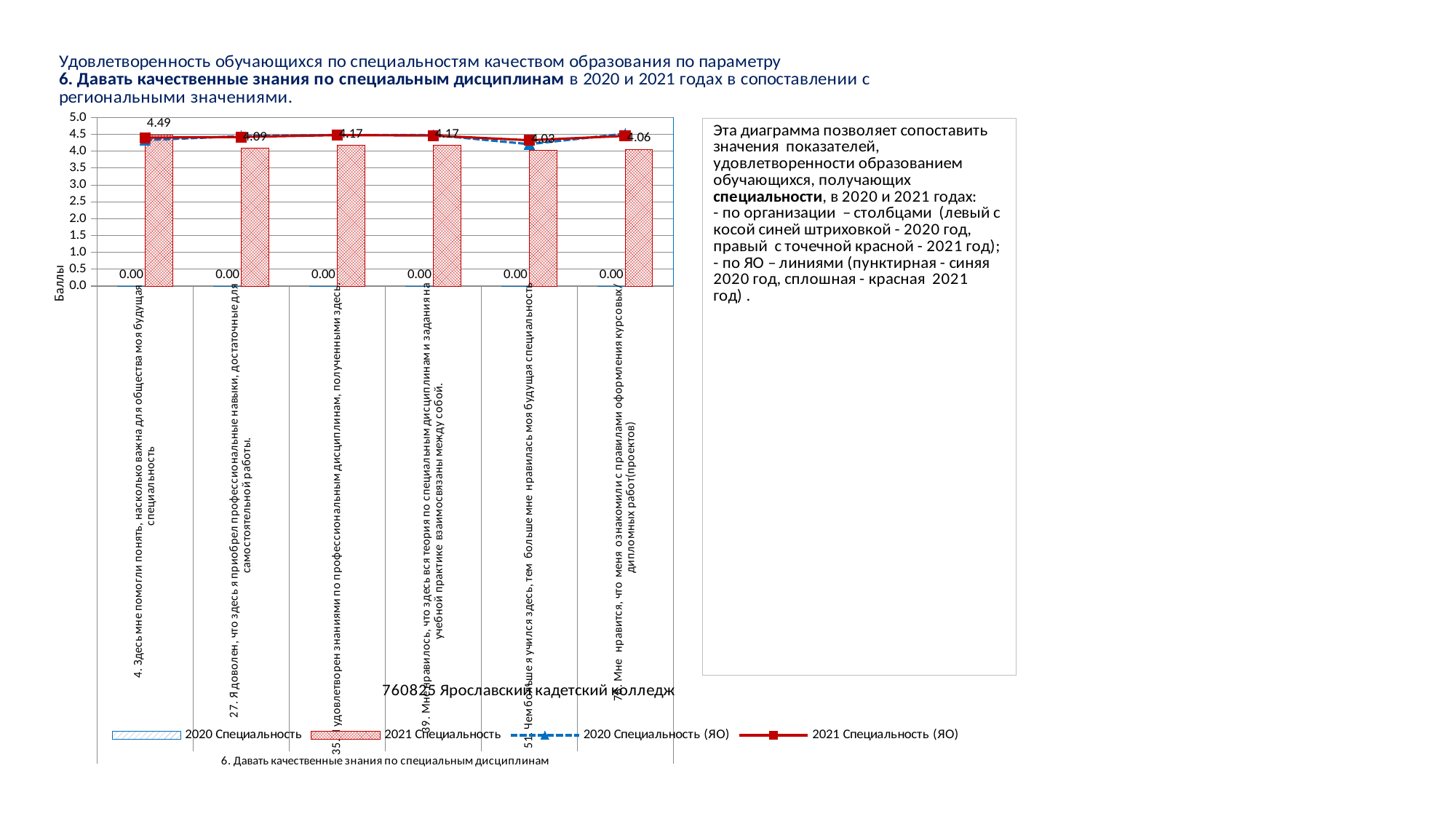
What is the difference between the 2021 Специальность values for question 4 and question 51? 0.46 What is the value of the 2021 Специальность bar for question 4 (Здесь мне помогли понять, насколько важна для общества моя будущая специальность)? 4.49 How many categories are shown on the x axis? 6 Which category has the lowest non-zero 2021 Специальность bar? 51. Чем больше я учился здесь, тем больше мне нравилась моя будущая специальность What is the title of the vertical axis? Баллы What is the value of the 2021 Специальность bar for question 51 (Чем больше я учился здесь, тем больше мне нравилась моя будущая специальность)? 4.03 Which category has the highest 2021 Специальность bar? 4. Здесь мне помогли понять, насколько важна для общества моя будущая специальность What value is shown for the 2020 Специальность series for question 39? 0.00 What is the value of the 2021 Специальность bar for question 27 (Я доволен, что здесь я приобрел профессиональные навыки, достаточные для самостоятельной работы)? 4.09 How many series does the legend list? 4 Which is larger: the 2021 Специальность value for question 27 or for question 35? question 35 (4.17) Is the 2021 Специальность (ЯО) line value for question 4 greater or less than 4.0? greater